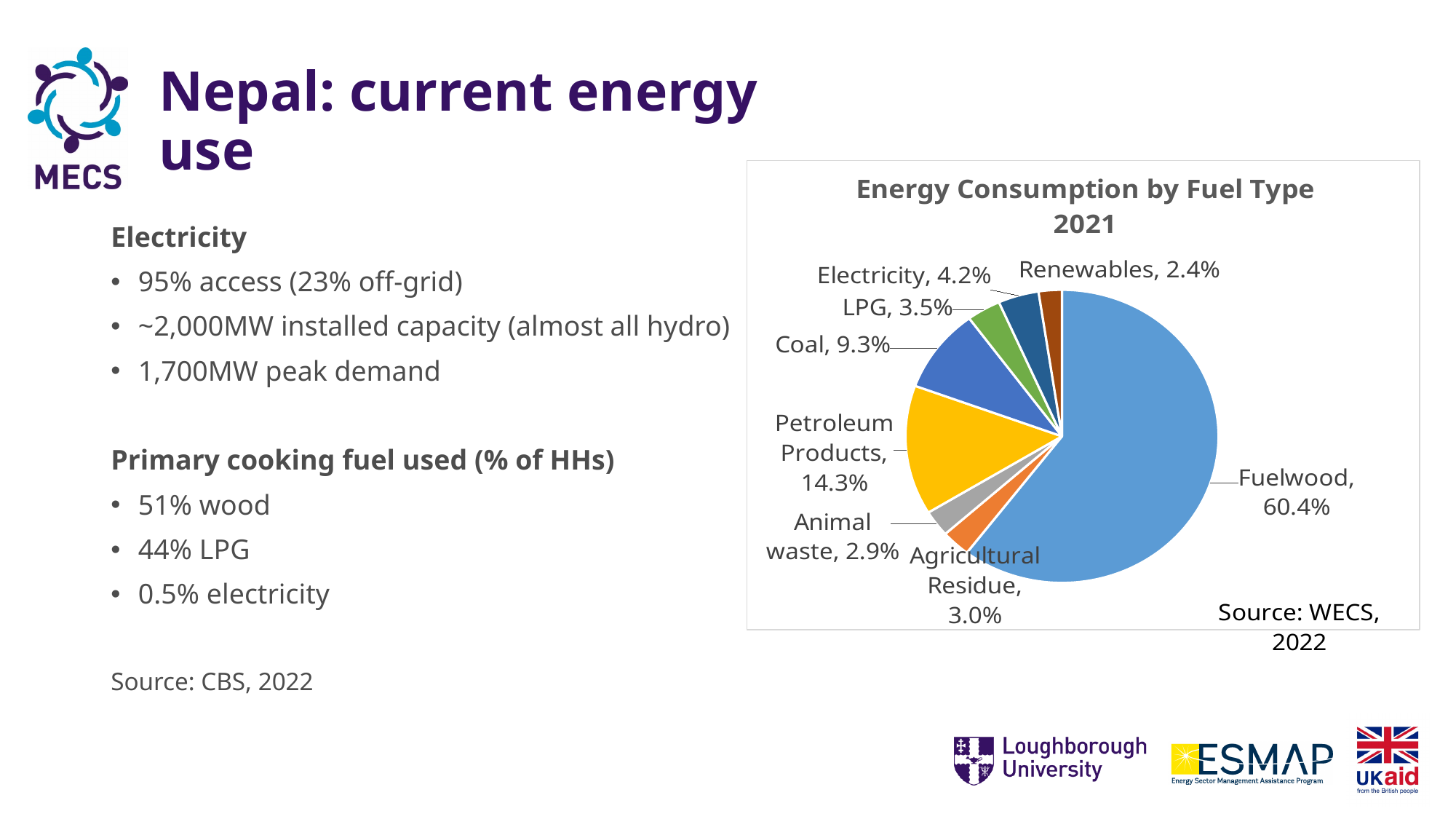
Which fuel type has the largest share of energy consumption? Fuelwood What is the value shown for Petroleum Products? 14.3% What is the title of the chart? Energy Consumption by Fuel Type 2021 Which fuel type has the smallest share of energy consumption? Renewables What is the value shown for Renewables? 2.4% What is the difference between the shares of Electricity and LPG? 0.7% What is the value shown for Coal? 9.3% What type of chart is shown on the slide? Pie chart Which has a larger share, Coal or LPG? Coal How many fuel type categories are shown in the pie chart? 8 What is the difference between the shares of Fuelwood and Petroleum Products? 46.1% What share of energy consumption does Fuelwood account for? 60.4%